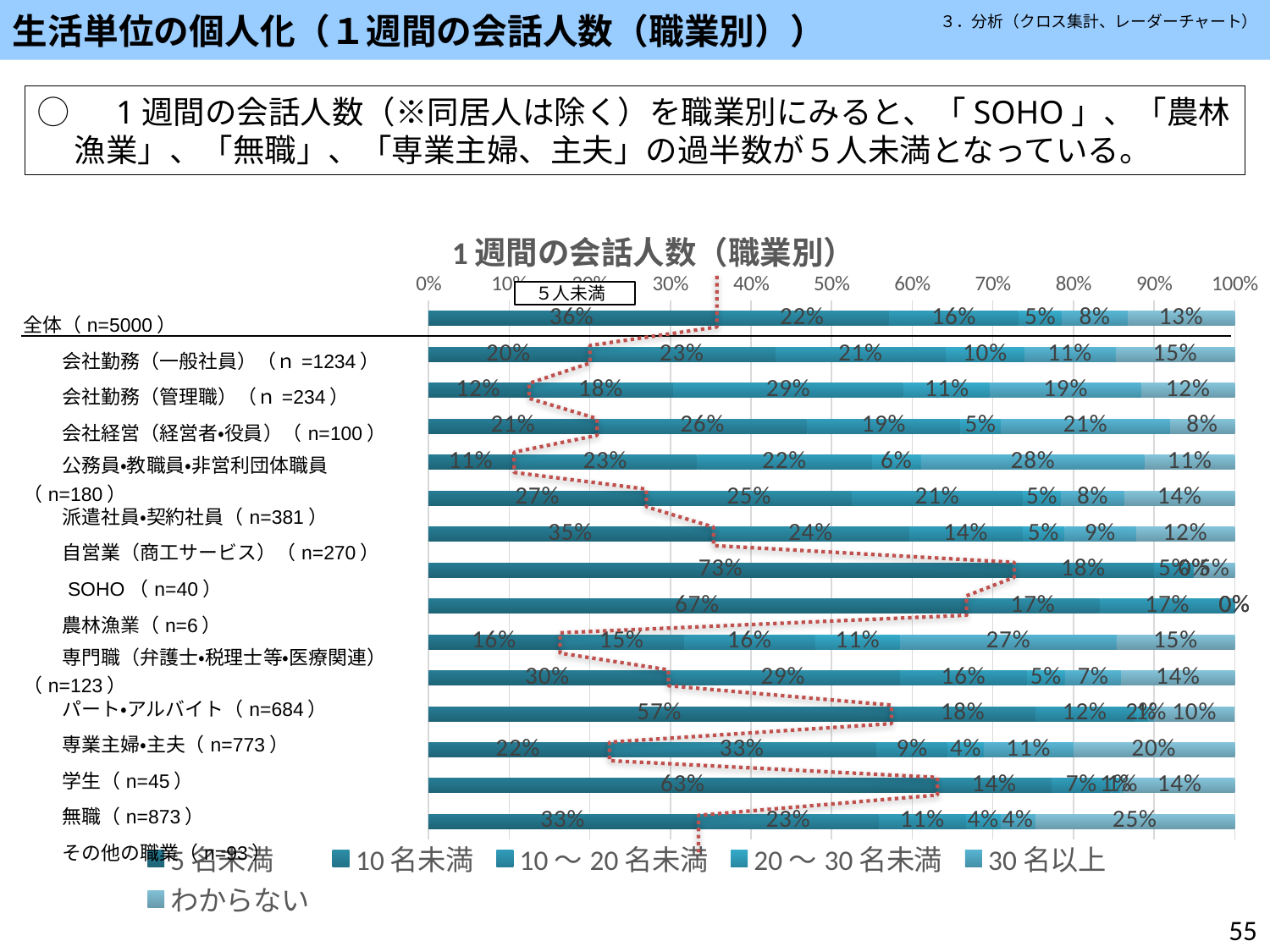
What is the value of 5名未満 for SOHO（n=40）? 73% What is the title of the chart? 1週間の会話人数（職業別） Which occupation has the lowest value for 5名未満? 公務員・教職員・非営利団体職員（n=180） Which occupation has the highest value for 5名未満? SOHO（n=40） Is the 5名未満 value for 専業主婦・主夫（n=773） greater or less than 50%? greater How many series does the legend list? 6 What is the difference between the 5名未満 value for 全体（n=5000） and for 会社勤務（一般社員）（n=1234）? 16 percentage points How many occupation categories (including 全体) are plotted in the chart? 15 What kind of chart is shown on the slide? Stacked bar chart What is the value of 10名未満 for 学生（n=45）? 33% Which has a larger 5名未満 value, 農林漁業（n=6） or 無職（n=873）? 農林漁業（n=6） What is the value of 5名未満 for 全体（n=5000）? 36%